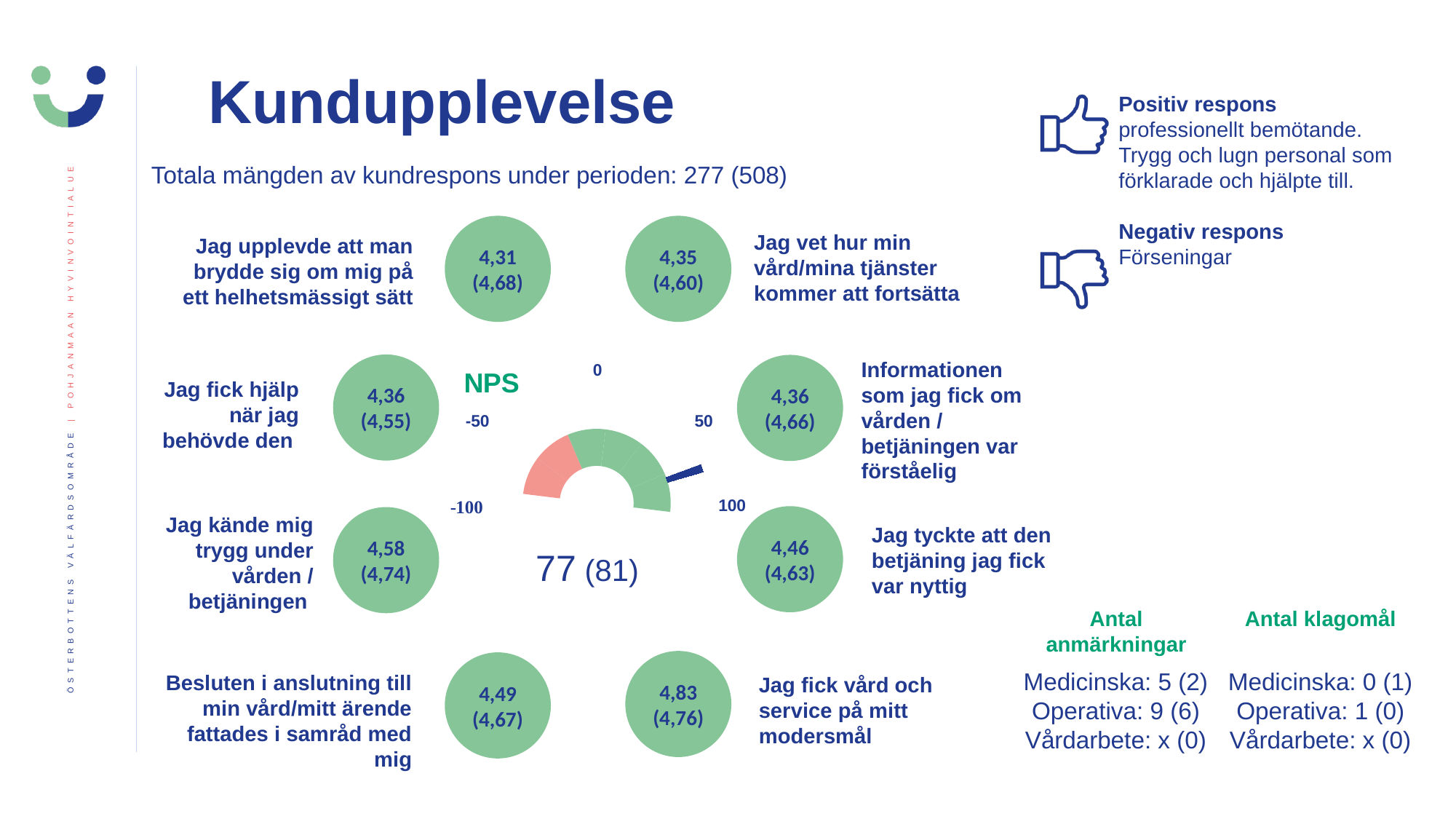
On the NPS gauge, is the needle value greater or less than 50? greater What value is shown in the green circle for 'Jag fick vård och service på mitt modersmål'? 4,83 (4,76) What title is printed next to the gauge chart? NPS How many tick labels are shown around the NPS gauge? 5 Which statement has the highest value in its green circle? Jag fick vård och service på mitt modersmål Which statement has the lowest value in its green circle? Jag upplevde att man brydde sig om mig på ett helhetsmässigt sätt What colour is the lowest segment of the NPS gauge arc? red What kind of chart is the NPS chart in the centre of the slide? gauge chart Which is larger: the green circle value for 'Jag kände mig trygg under vården / betjäningen' or for 'Jag fick hjälp när jag behövde den'? Jag kände mig trygg under vården / betjäningen What is the highest tick label shown on the NPS gauge scale? 100 What is the lowest tick label shown on the NPS gauge scale? -100 What NPS value is printed below the gauge chart? 77 (81)